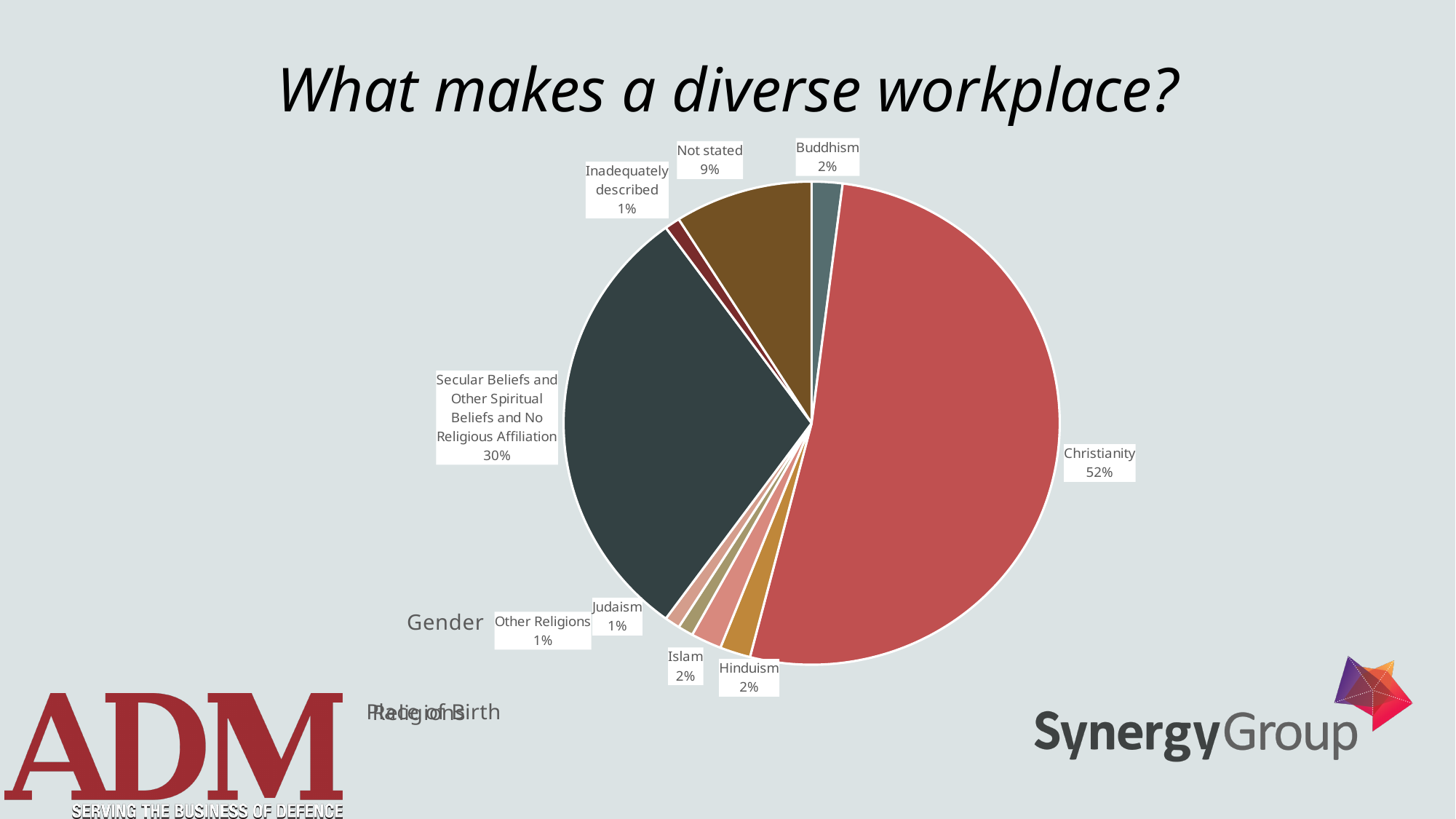
How many slices does the pie chart have? 9 What percentage is shown for Not stated? 9% What is the difference in percentage points between Christianity and Secular Beliefs and Other Spiritual Beliefs and No Religious Affiliation? 22 Which category has the largest slice of the pie? Christianity What kind of chart is shown on the slide? Pie chart What is the combined share of Islam and Hinduism? 4% What is the title of the slide containing the pie chart? What makes a diverse workplace? What percentage is shown for Secular Beliefs and Other Spiritual Beliefs and No Religious Affiliation? 30% What percentage is shown for Buddhism? 2% What percentage is shown for Judaism? 1% Which is larger, the slice for Not stated or the slice for Hinduism? Not stated What share of the pie does Christianity represent? 52%